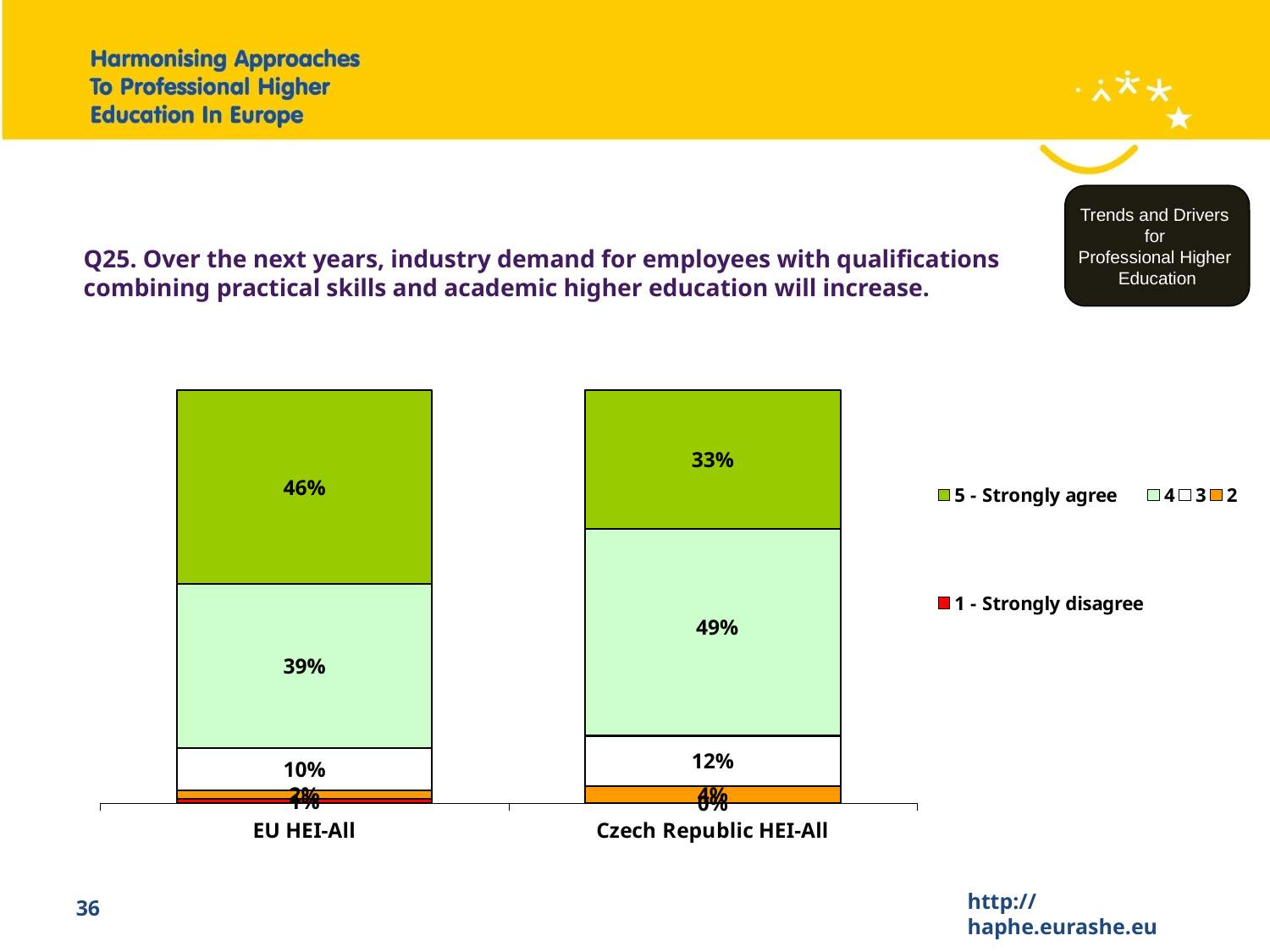
What is the value for "5 - Strongly agree" in the Czech Republic HEI-All bar? 33% What is the difference between the "5 - Strongly agree" share for EU HEI-All (46%) and for Czech Republic HEI-All (33%)? 13 percentage points What is the value for "3" in the EU HEI-All bar? 10% What is the value for "5 - Strongly agree" in the EU HEI-All bar? 46% How many series does the legend list? 5 What is the value for "4" in the Czech Republic HEI-All bar? 49% What is the value for "3" in the Czech Republic HEI-All bar? 12% What kind of chart is shown on the slide? Stacked bar chart Which response category has the largest share in the EU HEI-All bar? 5 - Strongly agree Which is larger: the "5 - Strongly agree" share for EU HEI-All or for Czech Republic HEI-All? EU HEI-All Which response category has the largest share in the Czech Republic HEI-All bar? 4 How many categories (bars) are shown on the x axis? 2